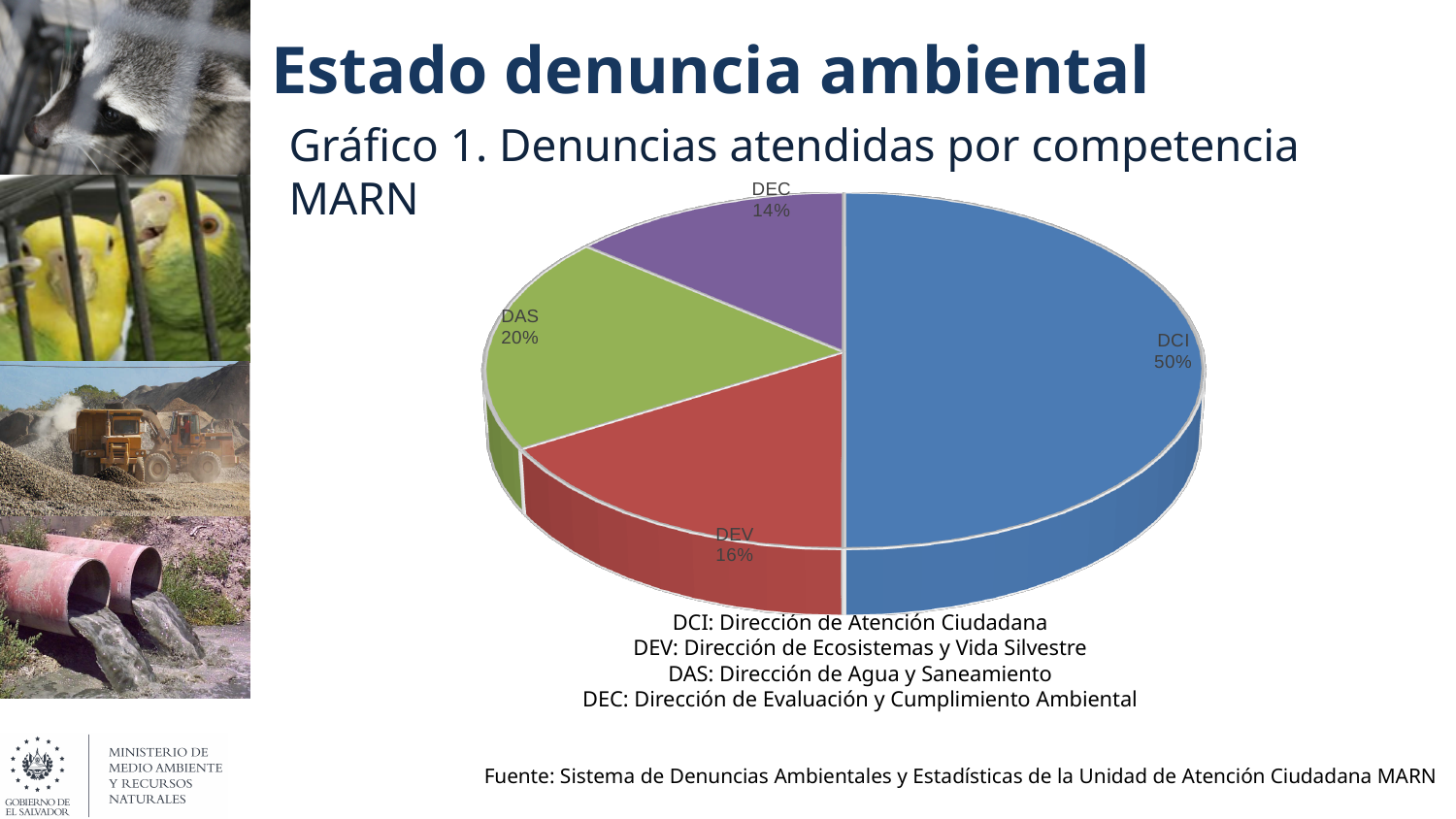
What share of the pie does DCI represent? 50% What colour is the DCI slice? Blue What share of the pie does DEC represent? 14% What kind of chart is shown on the slide? Pie chart Which category has the largest slice of the pie? DCI Which category has the smallest slice of the pie? DEC Which is larger, the share for DAS or the share for DEV? DAS How many categories are shown in the pie chart? 4 What share of the pie does DAS represent? 20% What share of the pie does DEV represent? 16% What is the difference in percentage points between DCI and DAS? 30 What is the title of the chart? Gráfico 1. Denuncias atendidas por competencia MARN